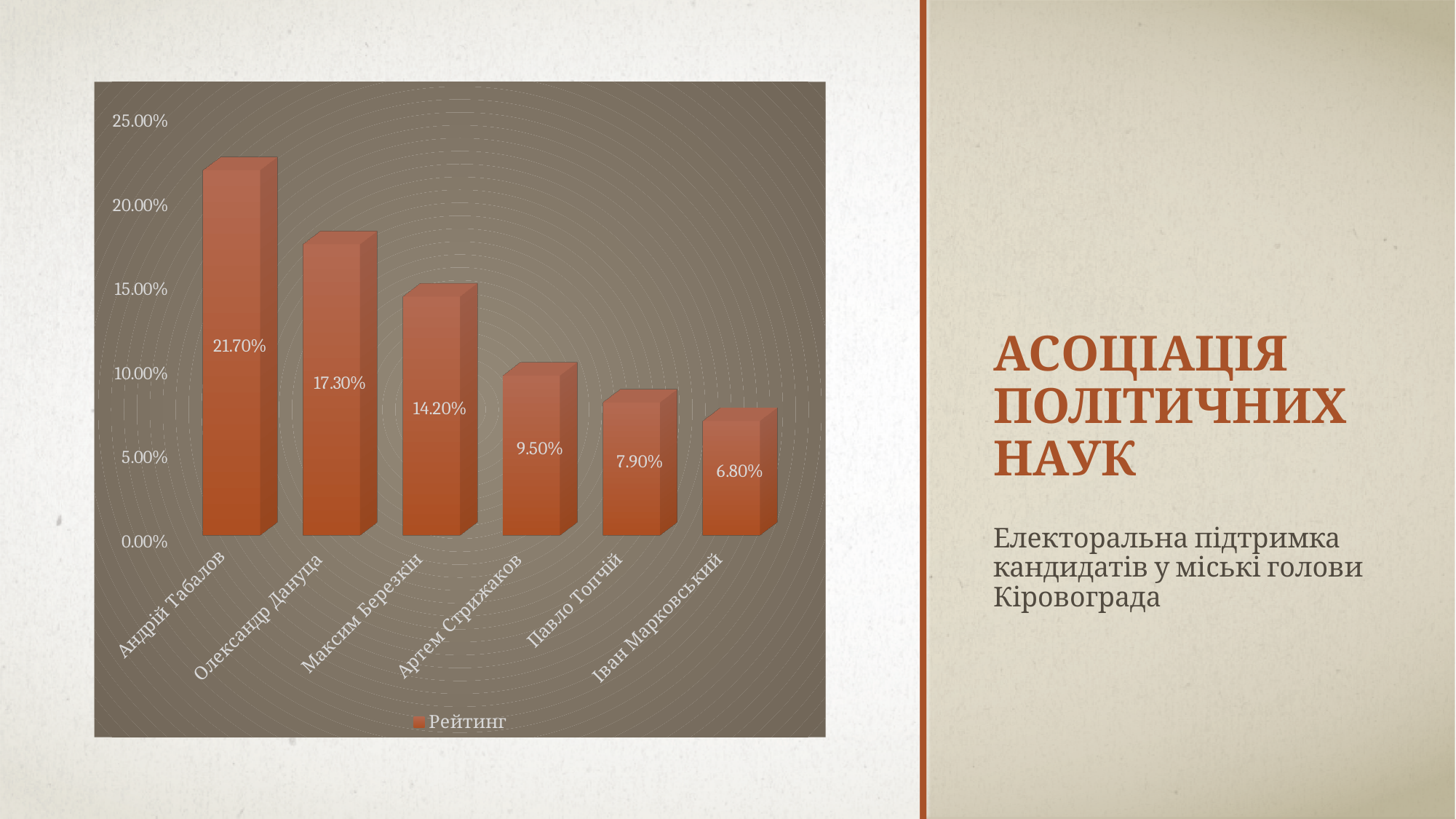
What is the difference between the values for Артем Стрижаков and Павло Топчій? 1.60% What is the value for Іван Марковський? 6.80% Which is larger, the value for Олександр Дануца or the value for Максим Березкін? Олександр Дануца How many candidates are shown in the chart? 6 What is the difference between the values for Андрій Табалов and Олександр Дануца? 4.40% What is the value for Максим Березкін? 14.20% What series name does the legend show? Рейтинг What is the value for Андрій Табалов? 21.70% Which candidate has the lowest value? Іван Марковський What kind of chart is shown on the slide? bar chart Is the value for Артем Стрижаков greater or less than 10.00%? less Which candidate has the highest value? Андрій Табалов